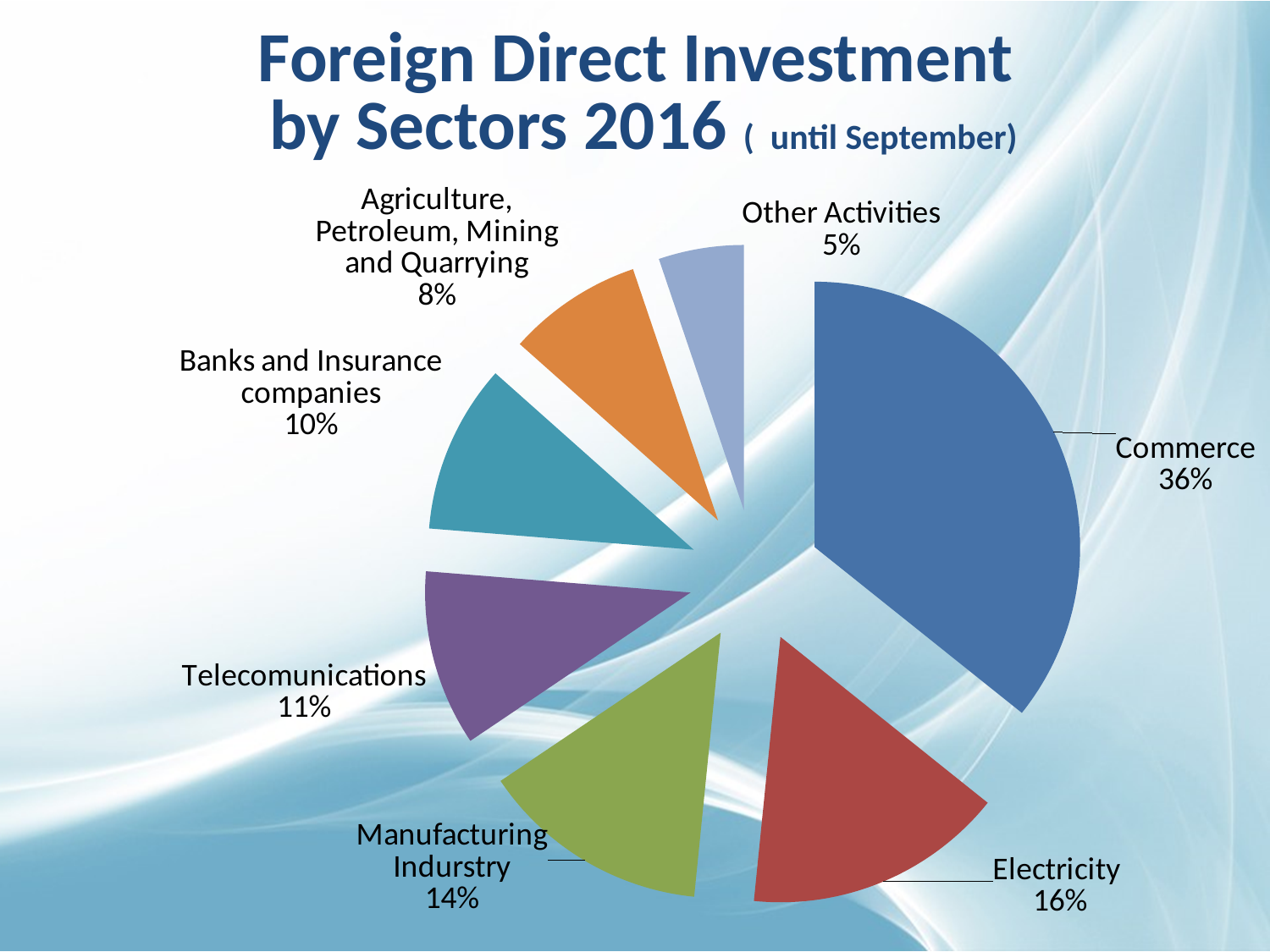
What share is shown for Banks and Insurance companies? 10% What percentage is shown for Telecomunications? 11% What percentage is shown for Electricity? 16% What percentage is shown for Other Activities? 5% What type of chart is shown on the slide? Pie chart What share of foreign direct investment does Commerce account for? 36% How many sectors are shown in the pie chart? 7 Which has a larger share, Telecomunications or Banks and Insurance companies? Telecomunications What is the difference in percentage points between Commerce and Electricity? 20 Which sector has the largest share of foreign direct investment? Commerce Which sector has the smallest share? Other Activities What share does Manufacturing Industry have? 14%